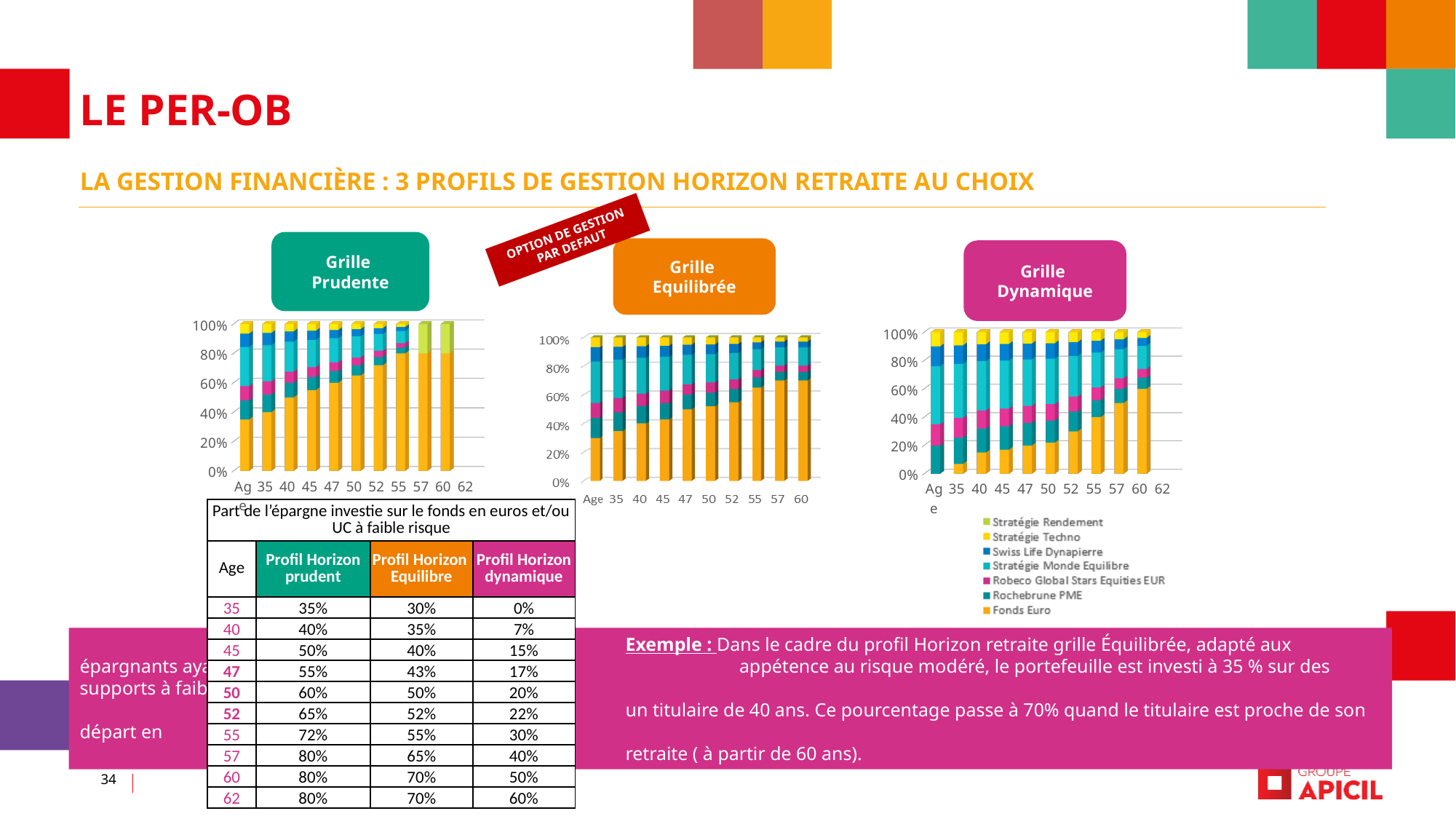
How many series does the legend list for the charts? 7 Which of the three grilles is marked as the default management option (option de gestion par défaut)? Grille Equilibrée On the Grille Prudente chart, is the Fonds Euro share at age 60 greater or less than 60%? greater How many age categories are plotted on the Grille Equilibrée chart? 9 How many age categories are plotted on the Grille Prudente chart? 10 On the Grille Dynamique chart, is the Fonds Euro share at age 35 greater or less than 20%? less On the Grille Equilibrée chart, is the Fonds Euro share at age 35 greater or less than 40%? less On the Grille Dynamique chart, does the Fonds Euro share rise or fall as age increases? Rises What kind of chart is the Grille Prudente chart? Stacked bar chart How many age categories are plotted on the Grille Dynamique chart? 10 Which legend entry is shown in orange on the charts? Fonds Euro